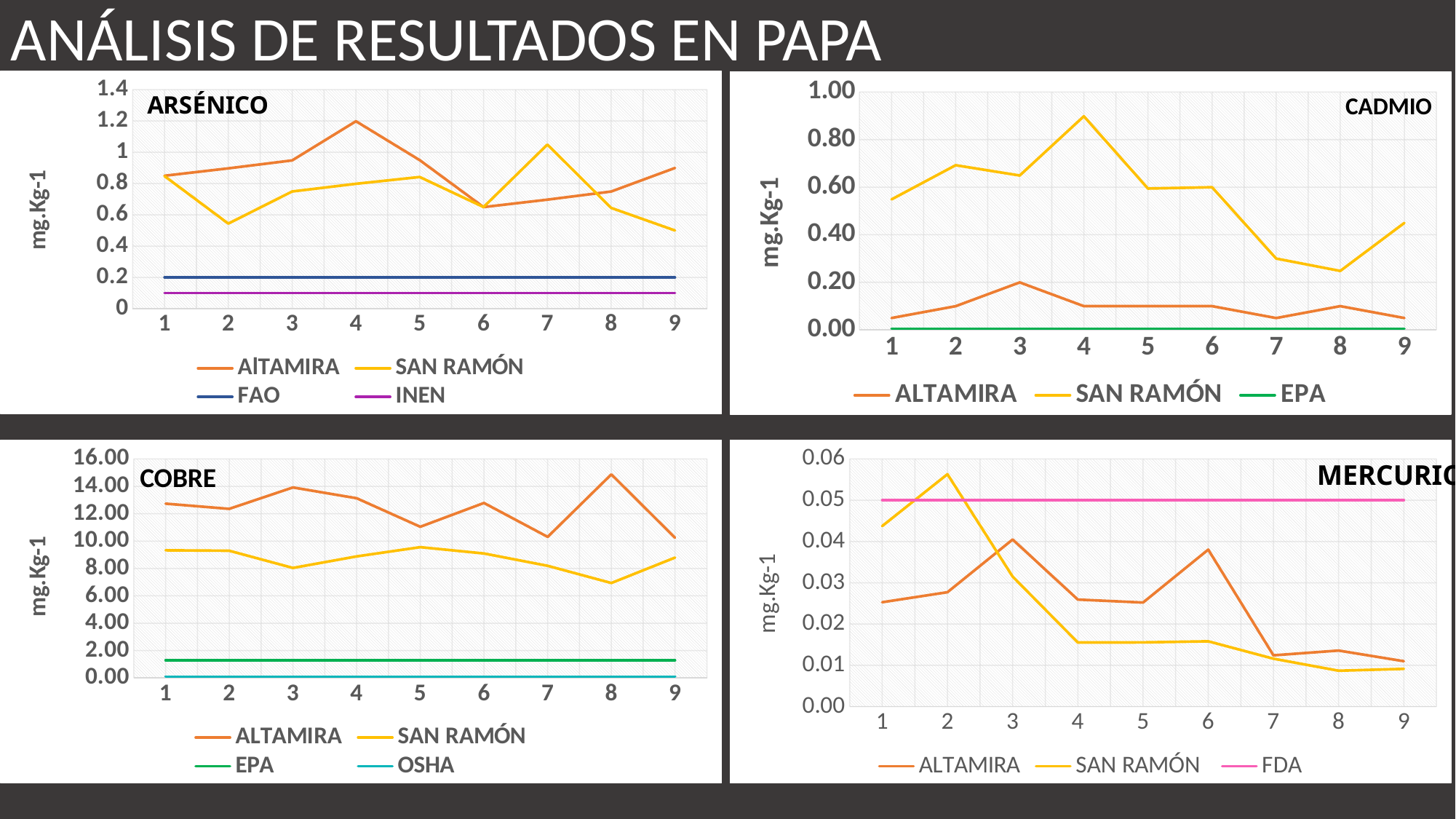
In the CADMIO chart, is the SAN RAMÓN value at point 4 greater or less than 0.80? greater What kind of chart is the ARSÉNICO chart? line chart How many series does the legend of the CADMIO chart list? 3 In the COBRE chart, which series is larger at point 1, ALTAMIRA or SAN RAMÓN? ALTAMIRA In the ARSÉNICO chart, at which x-axis point does the AlTAMIRA series reach its highest value? 4 In the CADMIO chart, at which x-axis point does the SAN RAMÓN series reach its highest value? 4 In the MERCURIO chart, does the SAN RAMÓN series rise or fall from point 2 to point 4? fall How many series does the legend of the ARSÉNICO chart list? 4 In the MERCURIO chart, is the SAN RAMÓN value at point 2 greater or less than 0.05? greater In the COBRE chart, at which x-axis point does the ALTAMIRA series reach its highest value? 8 How many x-axis points are plotted in the COBRE chart? 9 In the ARSÉNICO chart, is the AlTAMIRA value at point 4 greater or less than 1? greater